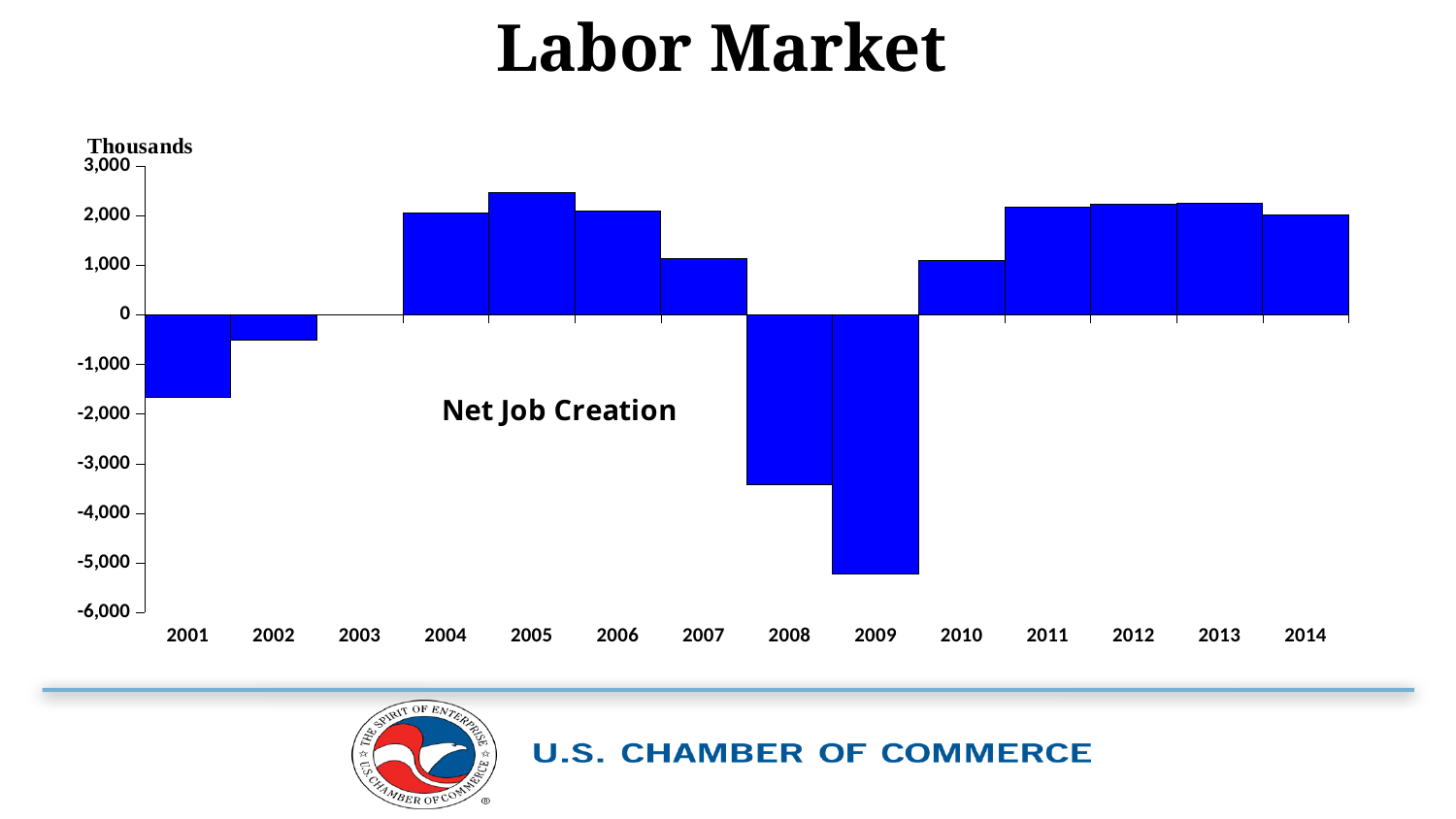
What kind of chart is shown on the slide? bar chart Which year has the larger value, 2005 or 2007? 2005 Which year has the lowest net job creation? 2009 Is the value for 2007 greater or less than 2,000? less Is the value for 2009 greater or less than -4,000? less Is the value for 2008 greater or less than -3,000? less Which year has the highest net job creation? 2005 What unit label is shown above the y axis of the chart? Thousands How many years are shown on the x axis of the chart? 14 Do the values rise or fall from 2010 to 2013? rise